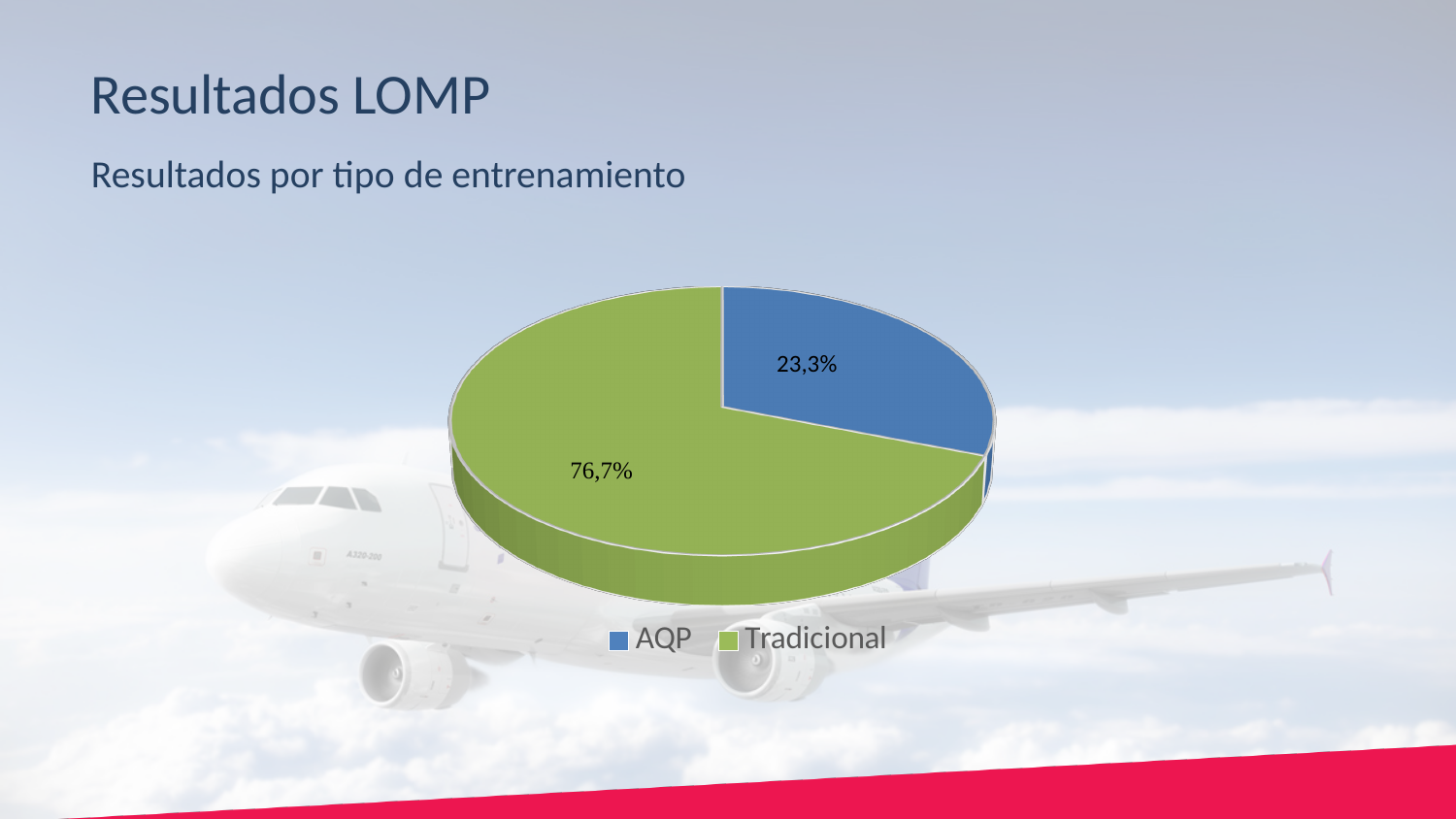
Which category has the largest slice of the pie? Tradicional Which category has the smallest slice of the pie? AQP What share of the pie does AQP represent? 23,3% What colour is the AQP slice? Blue What share of the pie does Tradicional represent? 76,7% How many entries does the legend list? 2 What is the difference in percentage points between the Tradicional and AQP slices? 53,4 Which is larger, the AQP slice or the Tradicional slice? Tradicional How many categories does the pie chart show? 2 What colour is the Tradicional slice? Green What kind of chart is shown on the slide? Pie chart